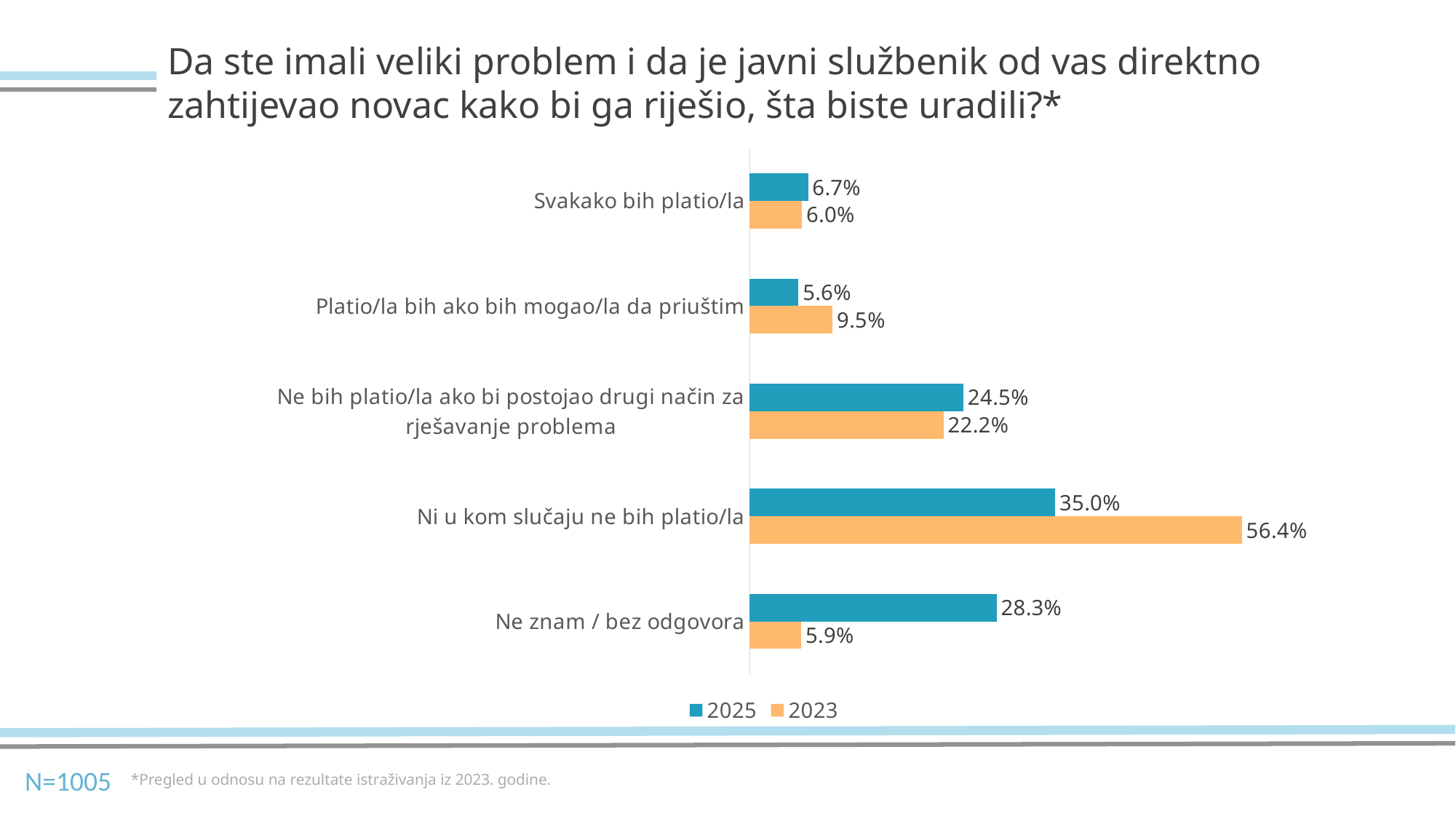
For "Ne bih platio/la ako bi postojao drugi način za rješavanje problema", which year has the larger value, 2025 or 2023? 2025 What is the 2023 value for "Ne znam / bez odgovora"? 5.9% What is the difference between the 2025 and 2023 values for "Ne znam / bez odgovora"? 22.4% Which series is shown in orange in the legend? 2023 Which category has the lowest 2025 value? Platio/la bih ako bih mogao/la da priuštim What is the difference between the 2023 and 2025 values for "Ni u kom slučaju ne bih platio/la"? 21.4% How many categories are shown in the chart? 5 What is the 2025 value for "Ni u kom slučaju ne bih platio/la"? 35.0% What kind of chart is shown on the slide? Bar chart Which category has the highest 2023 value? Ni u kom slučaju ne bih platio/la How many series does the legend list? 2 What is the 2023 value for "Platio/la bih ako bih mogao/la da priuštim"? 9.5%